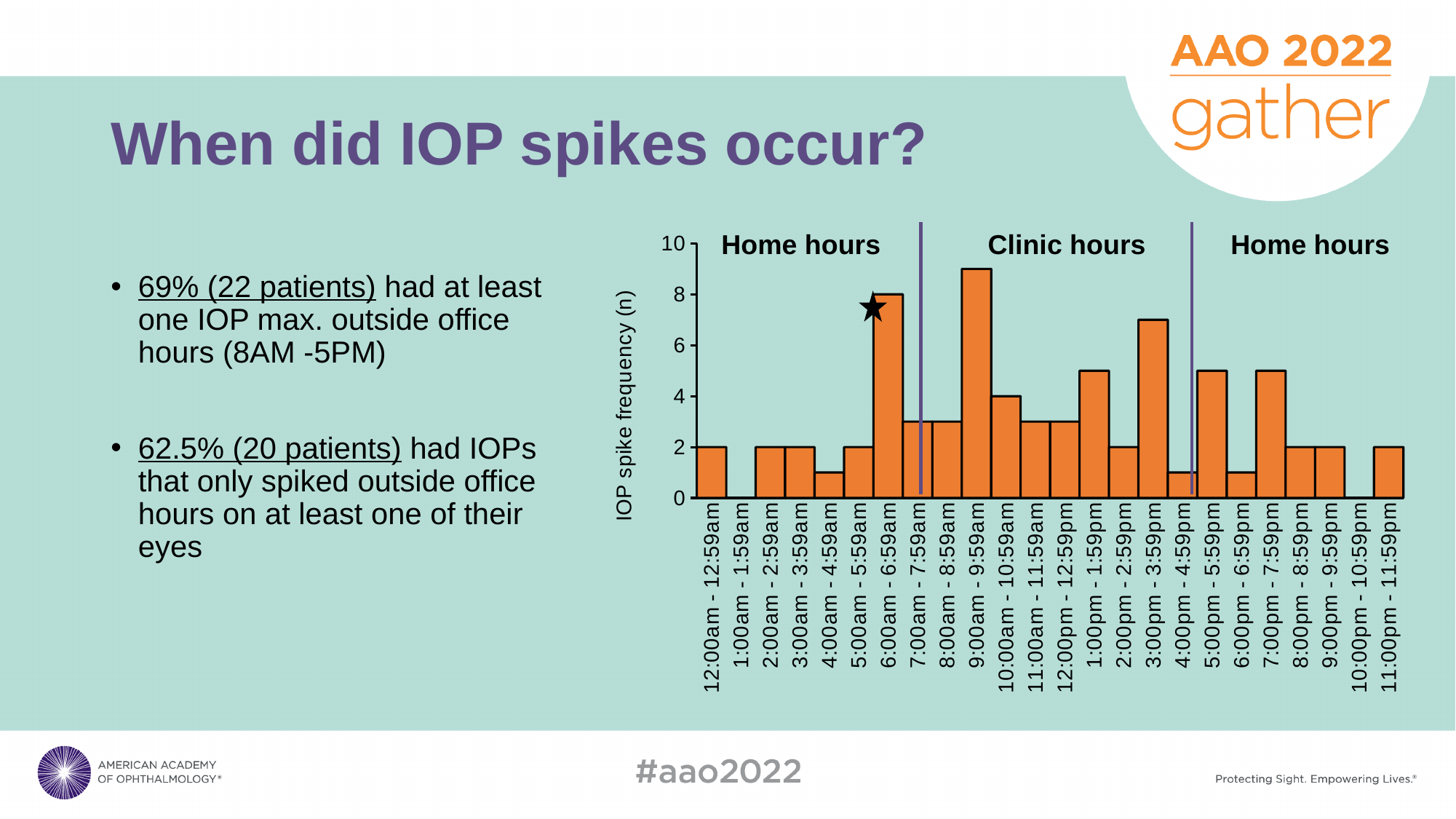
What is the IOP spike frequency for the 10:00am - 10:59am bin? 4 Is the IOP spike frequency for the 3:00pm - 3:59pm bin greater or less than 6? greater How many hourly time bins are shown on the x axis of the chart? 24 What is the IOP spike frequency for the 6:00am - 6:59am bin? 8 What is the difference in IOP spike frequency between the 6:00am - 6:59am bin and the 10:00am - 10:59am bin? 4 Is the IOP spike frequency for the 9:00am - 9:59am bin greater or less than 8? greater Which time bin has the highest IOP spike frequency? 9:00am - 9:59am What kind of chart is shown on the slide? bar chart What is the label of the y axis of the chart? IOP spike frequency (n) What is the IOP spike frequency for the 9:00pm - 9:59pm bin? 2 What is the IOP spike frequency for the 12:00am - 12:59am bin? 2 Which bin has a higher IOP spike frequency, 6:00am - 6:59am or 3:00pm - 3:59pm? 6:00am - 6:59am